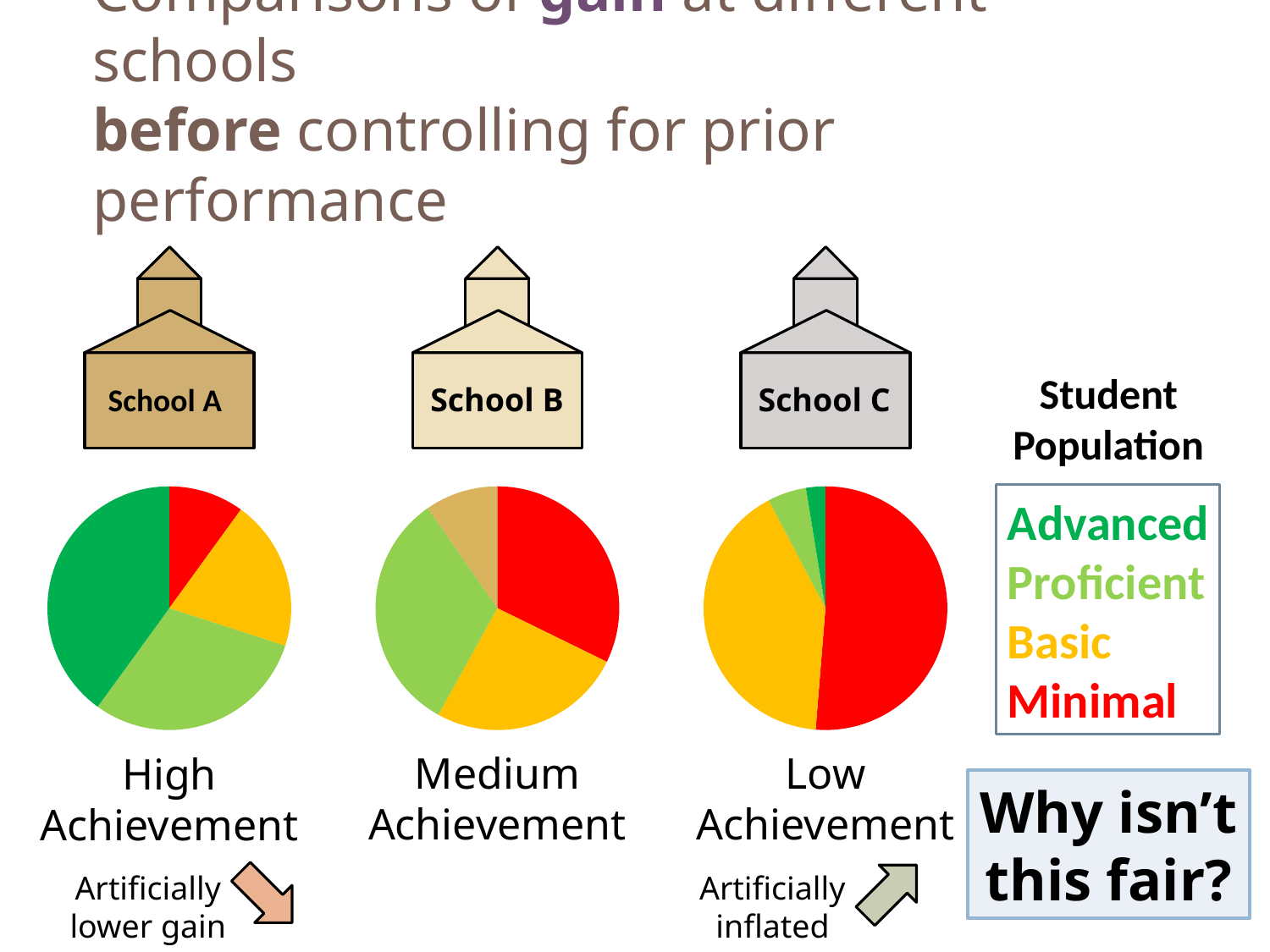
In the School C pie chart, which slice is larger, Minimal or Basic? Minimal How many categories does the Student Population legend list? 4 How many charts are shown on the slide? 3 In the School A pie chart, which slice is larger, Basic or Minimal? Basic In the School C pie chart, which category has the smallest slice? Advanced Which colour represents the Minimal category in the legend? red Which school's pie chart is labelled Low Achievement? School C In the School C pie chart, which category has the largest slice? Minimal How many slices does the School A pie chart have? 4 What kind of chart is used for School A? pie chart In the School C pie chart, which slice is larger, Proficient or Advanced? Proficient In the School A pie chart, which category has the smallest slice? Minimal